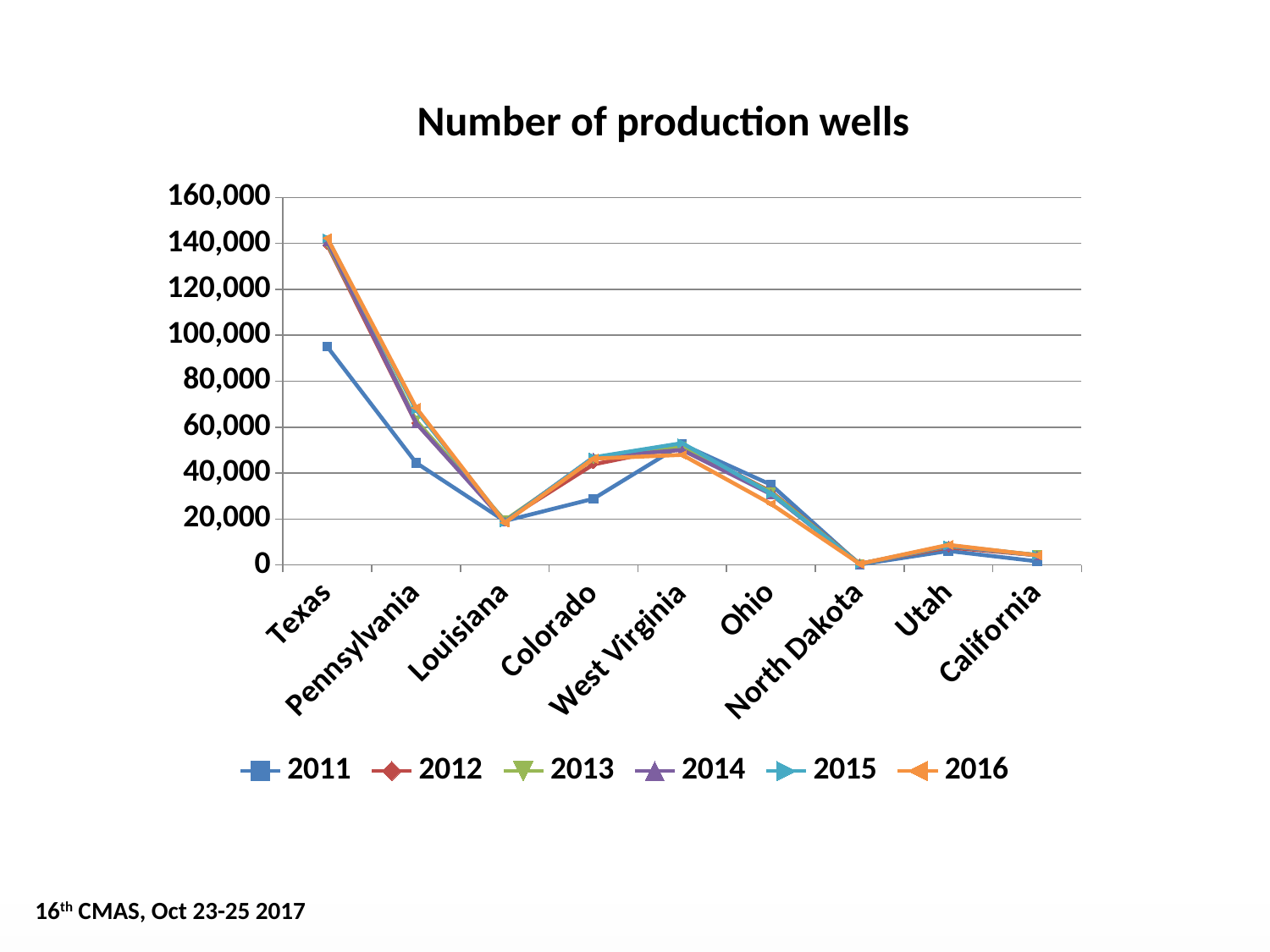
Is the value for Texas in 2011 greater or less than 80,000? greater How many series does the legend list? 6 Which state has the highest number of production wells in 2011? Texas In 2011, which state has more production wells: Colorado or West Virginia? West Virginia What kind of chart is shown on the slide? line chart How many states are shown on the x axis? 9 Which is larger for Texas: the 2011 value or the 2016 value? 2016 What is the title of the chart? Number of production wells Is the value for Louisiana in 2011 greater or less than 40,000? less Is the value for Texas in 2016 greater or less than 120,000? greater Which state has the lowest number of production wells in 2016? North Dakota